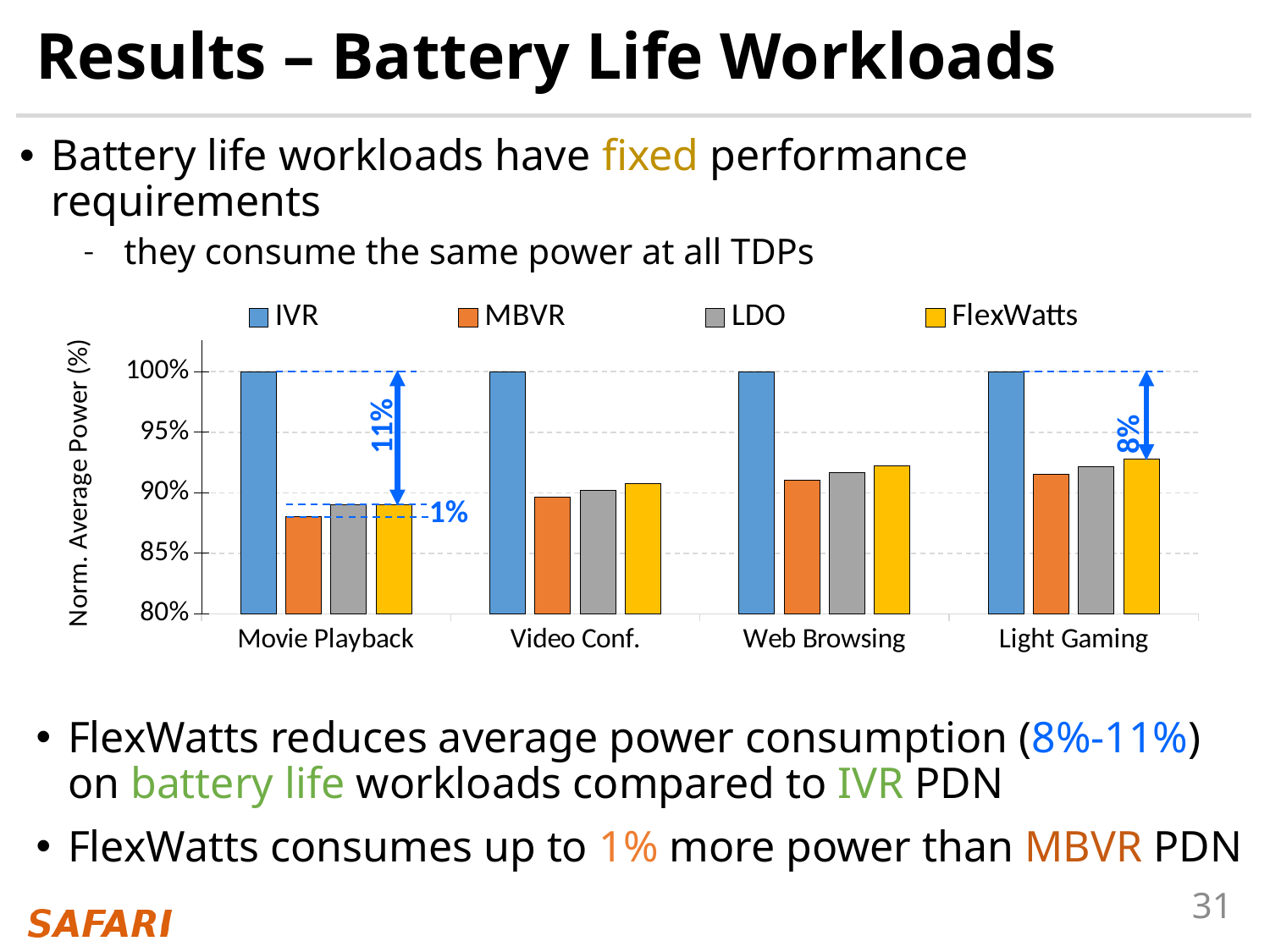
What percentage reduction is annotated between the IVR and FlexWatts bars for Movie Playback? 11% What is the value of the IVR bar for Light Gaming? 100% Is the FlexWatts value for Web Browsing greater or less than 90%? greater How many series does the legend list? 4 Is the LDO value for Light Gaming greater or less than 90%? greater Which series has the highest value for Video Conf.? IVR What is the value of the IVR bar for Movie Playback? 100% What percentage reduction is annotated between the IVR and FlexWatts bars for Light Gaming? 8% Which is larger for FlexWatts: the Movie Playback value or the Light Gaming value? Light Gaming Is the MBVR value for Movie Playback greater or less than 90%? less How many workload categories are shown on the x axis? 4 What difference is annotated between the FlexWatts and MBVR bars for Movie Playback? 1%